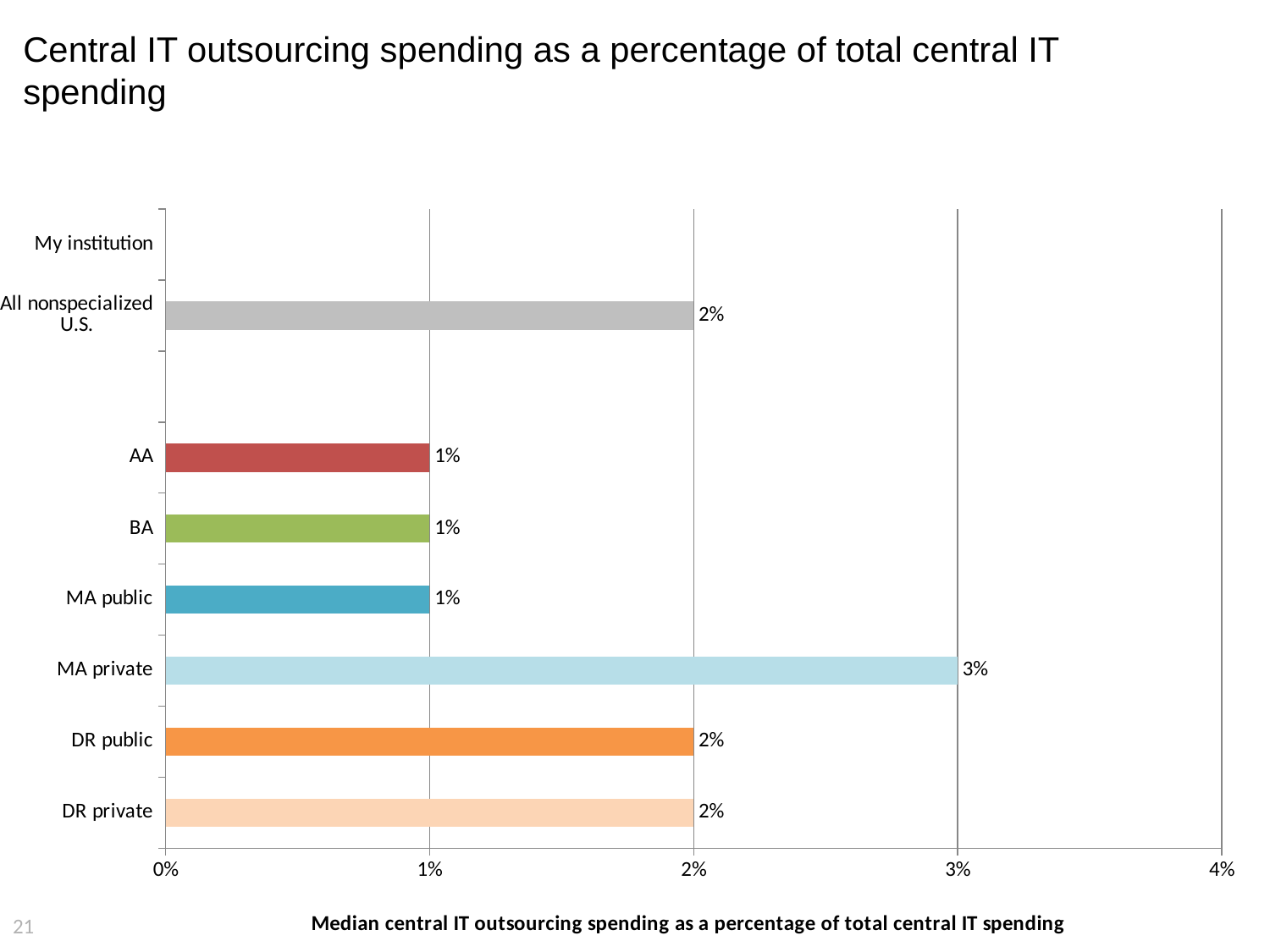
Is the value for MA private greater or less than 2%? greater What is the value for MA private? 3% What is the value for DR public? 2% What is the difference between the values for MA private and MA public? 2% What is the value for AA? 1% What is the value for All nonspecialized U.S.? 2% Which category has the highest value? MA private How many categories have a bar plotted on the chart? 7 What kind of chart is shown on the slide? Bar chart Which is larger, the value for DR private or the value for BA? DR private What is the value for MA public? 1% What is the label shown below the x axis of the chart? Median central IT outsourcing spending as a percentage of total central IT spending